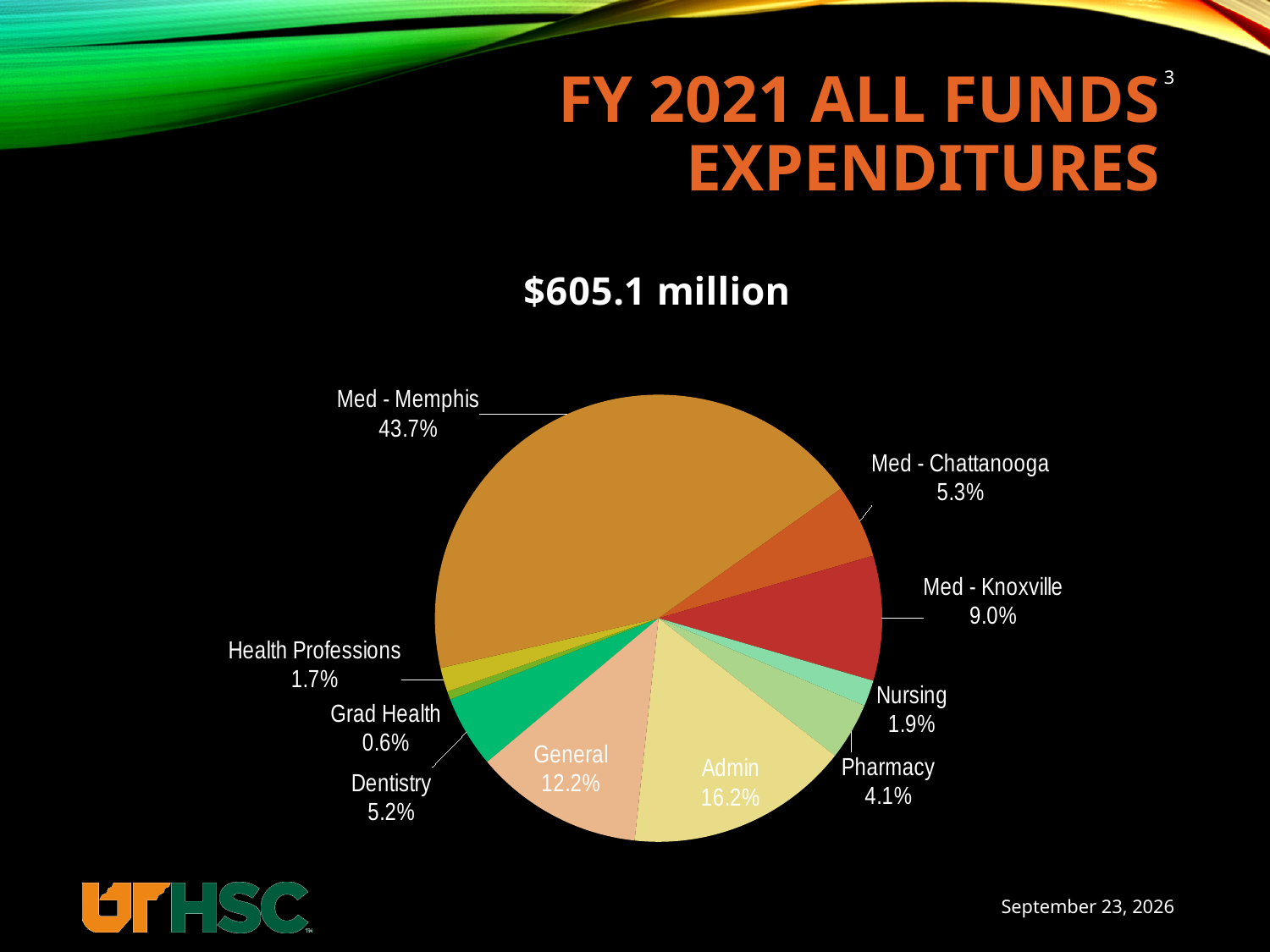
How many categories are shown in the pie chart? 10 What is the percentage shown for Pharmacy? 4.1% What is the difference in percentage points between Admin and General? 4.0 percentage points Which category has the largest slice of the pie? Med - Memphis What is the percentage shown for Med - Knoxville? 9.0% What is the difference in percentage points between Nursing and Health Professions? 0.2 percentage points What percentage of expenditures does Admin account for? 16.2% What share of FY 2021 all funds expenditures is attributed to Med - Memphis? 43.7% Which is larger, the share for Med - Chattanooga or the share for Dentistry? Med - Chattanooga What total dollar amount is shown above the pie chart? $605.1 million Which category has the smallest slice of the pie? Grad Health What type of chart is shown on the slide? Pie chart